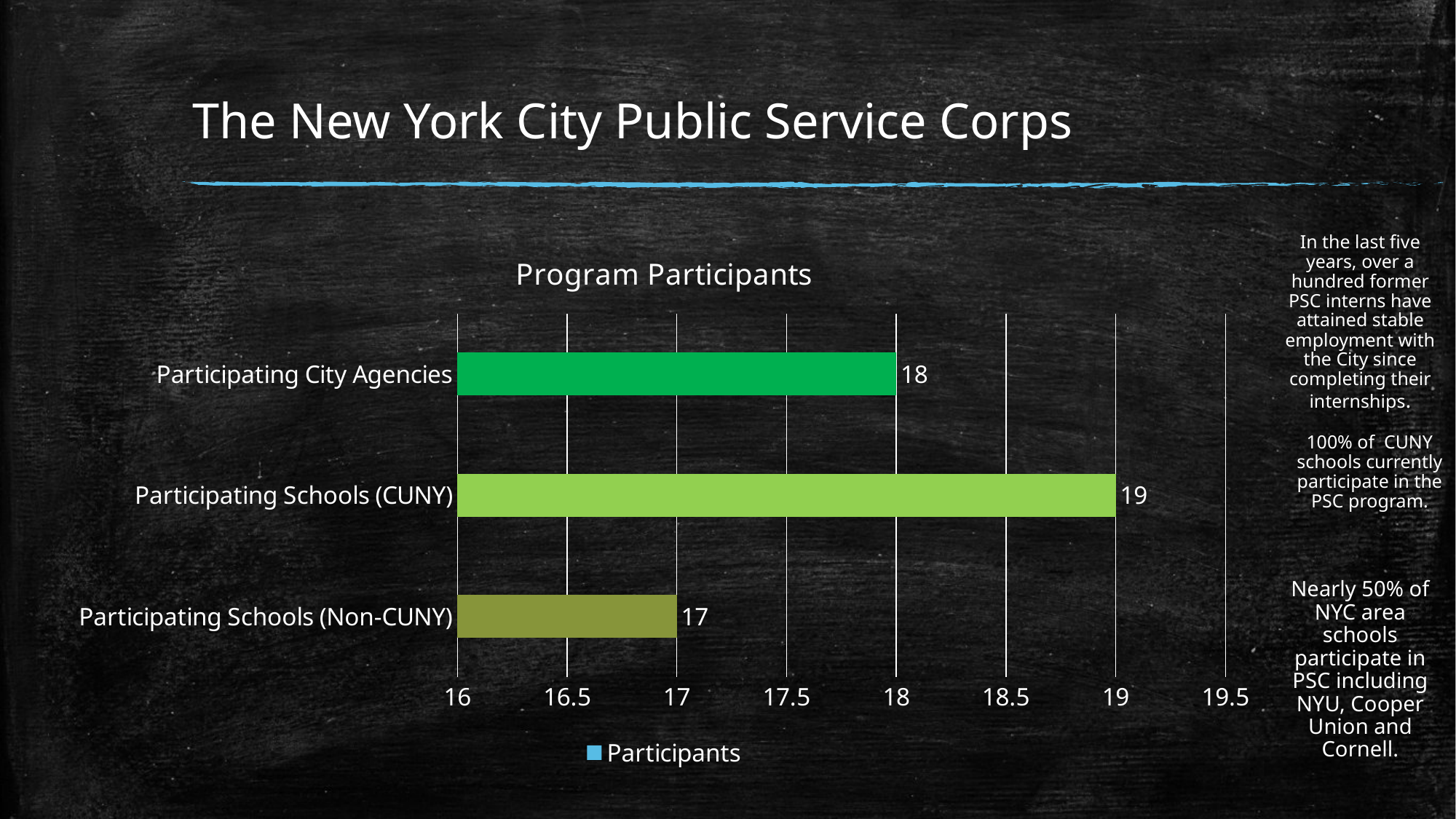
What is the value for Participating Schools (CUNY)? 19 What is the value for Participating Schools (Non-CUNY)? 17 Which category has the highest value? Participating Schools (CUNY) Which category has the lowest value? Participating Schools (Non-CUNY) Which is larger, the value for Participating City Agencies or the value for Participating Schools (Non-CUNY)? Participating City Agencies How many categories are shown in the chart? 3 What kind of chart is shown on the slide? bar chart What is the value for Participating City Agencies? 18 What is the difference between the values for Participating Schools (CUNY) and Participating Schools (Non-CUNY)? 2 What is the title of the chart? Program Participants Is the value for Participating Schools (CUNY) greater or less than 18.5? greater How many series does the legend list? 1